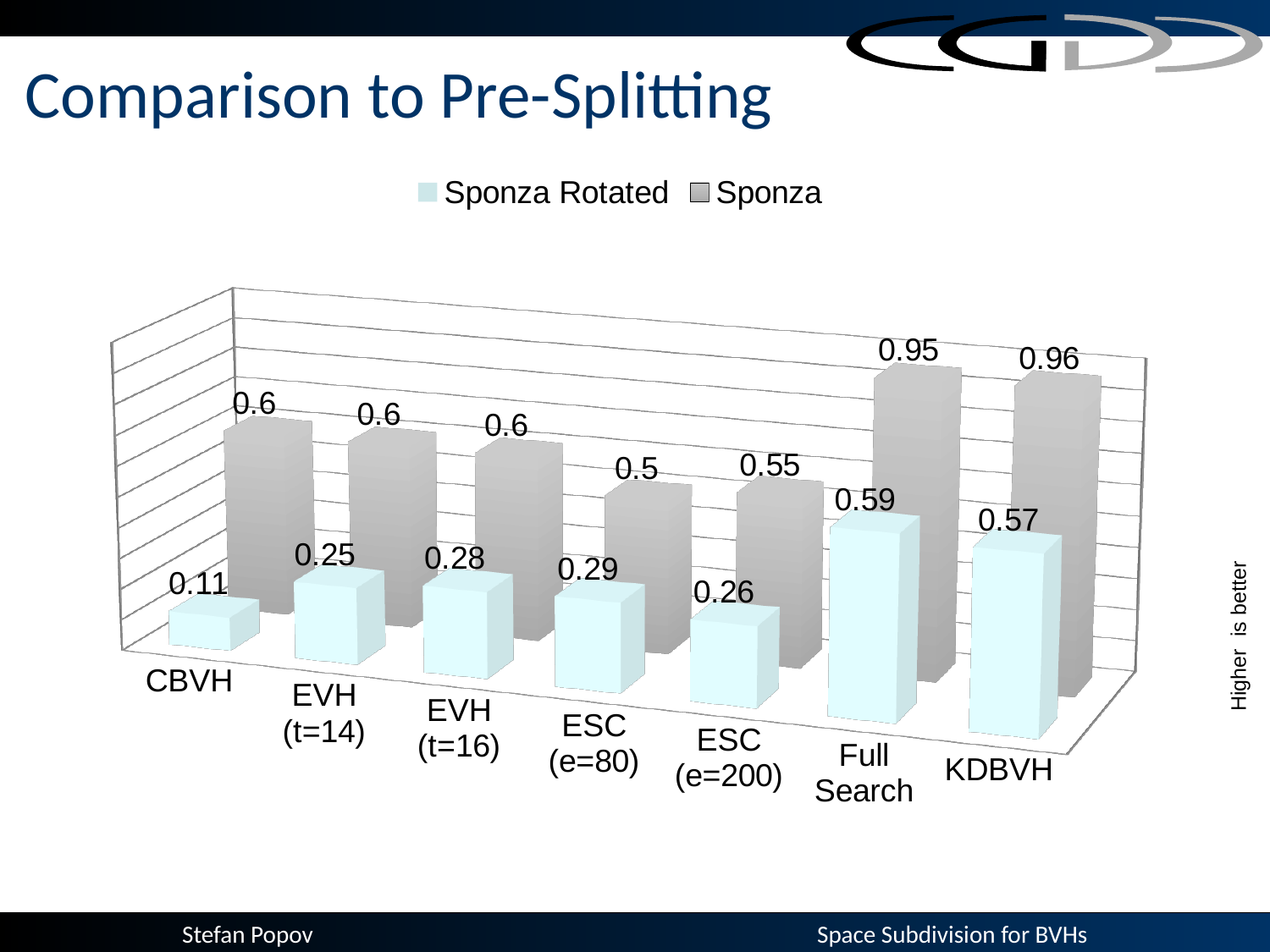
What is the Sponza Rotated value for Full Search? 0.59 What is the Sponza value for ESC (e=200)? 0.55 What is the difference between the Sponza and Sponza Rotated values for CBVH? 0.49 How many series does the legend list? 2 What kind of chart is shown on the slide? Bar chart What is the Sponza value for KDBVH? 0.96 Which is larger for ESC (e=80): the Sponza value or the Sponza Rotated value? Sponza Which category has the lowest Sponza Rotated value? CBVH Which category has the lowest Sponza value? ESC (e=80) How many categories are shown on the x axis? 7 What is the Sponza Rotated value for CBVH? 0.11 Which category has the highest Sponza Rotated value? Full Search